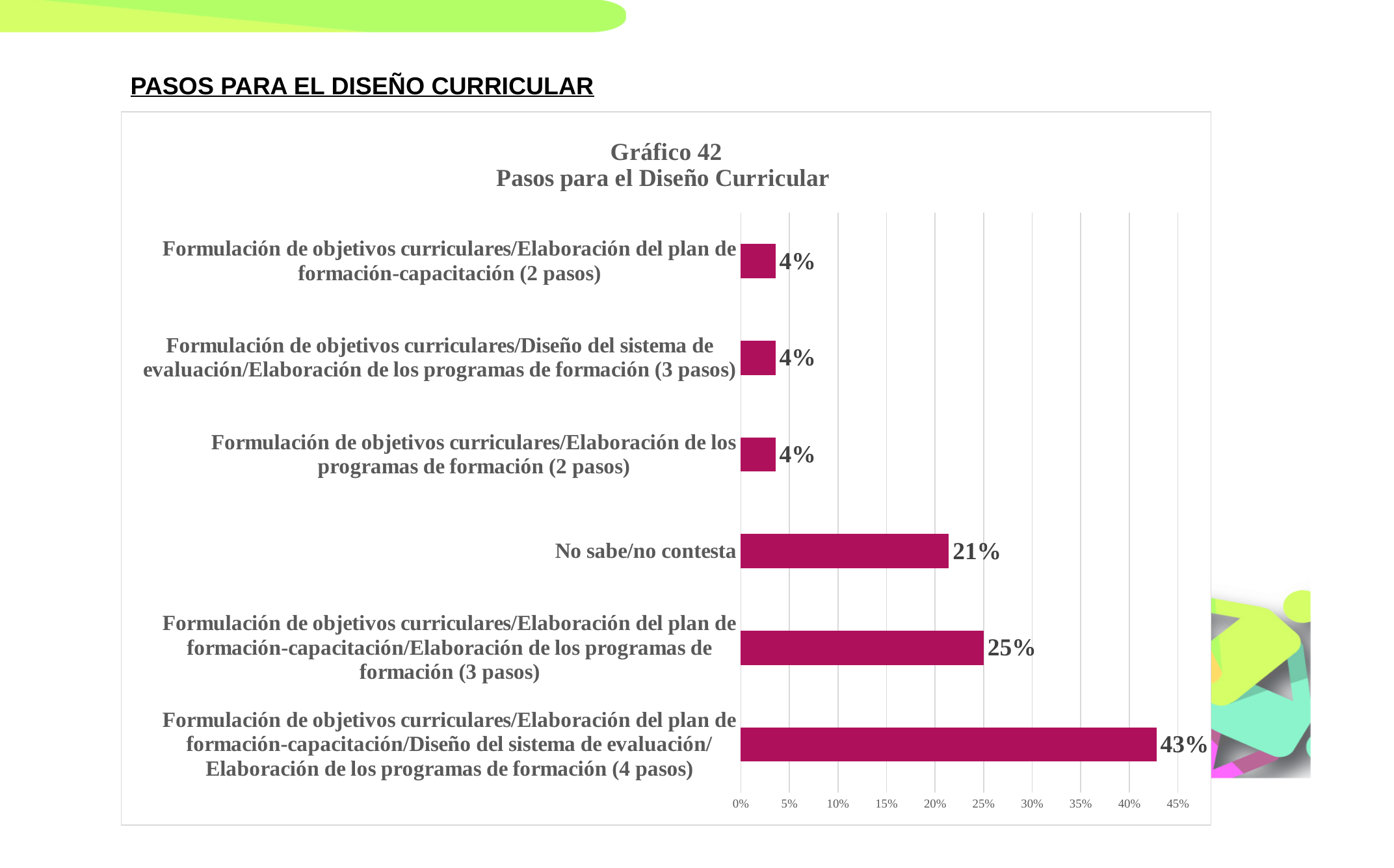
What is the value for 'No sabe/no contesta'? 21% What is the value for the 4-step option (Formulación de objetivos curriculares/Elaboración del plan de formación-capacitación/Diseño del sistema de evaluación/Elaboración de los programas de formación)? 43% What is the value for 'Formulación de objetivos curriculares/Elaboración del plan de formación-capacitación/Elaboración de los programas de formación (3 pasos)'? 25% What is the value for 'Formulación de objetivos curriculares/Elaboración de los programas de formación (2 pasos)'? 4% Is the value for 'No sabe/no contesta' greater or less than 15%? greater How many categories are shown in the chart? 6 What is the title of the chart? Gráfico 42 Pasos para el Diseño Curricular Which is larger: 'No sabe/no contesta' or 'Formulación de objetivos curriculares/Elaboración del plan de formación-capacitación/Elaboración de los programas de formación (3 pasos)'? Formulación de objetivos curriculares/Elaboración del plan de formación-capacitación/Elaboración de los programas de formación (3 pasos) What kind of chart is shown? Bar chart Which category has the highest value? Formulación de objetivos curriculares/Elaboración del plan de formación-capacitación/Diseño del sistema de evaluación/Elaboración de los programas de formación (4 pasos) What is the difference between the 4-step option (43%) and the 3-step option with plan de formación-capacitación (25%)? 18% What is the difference between 'No sabe/no contesta' and 'Formulación de objetivos curriculares/Elaboración de los programas de formación (2 pasos)'? 17%